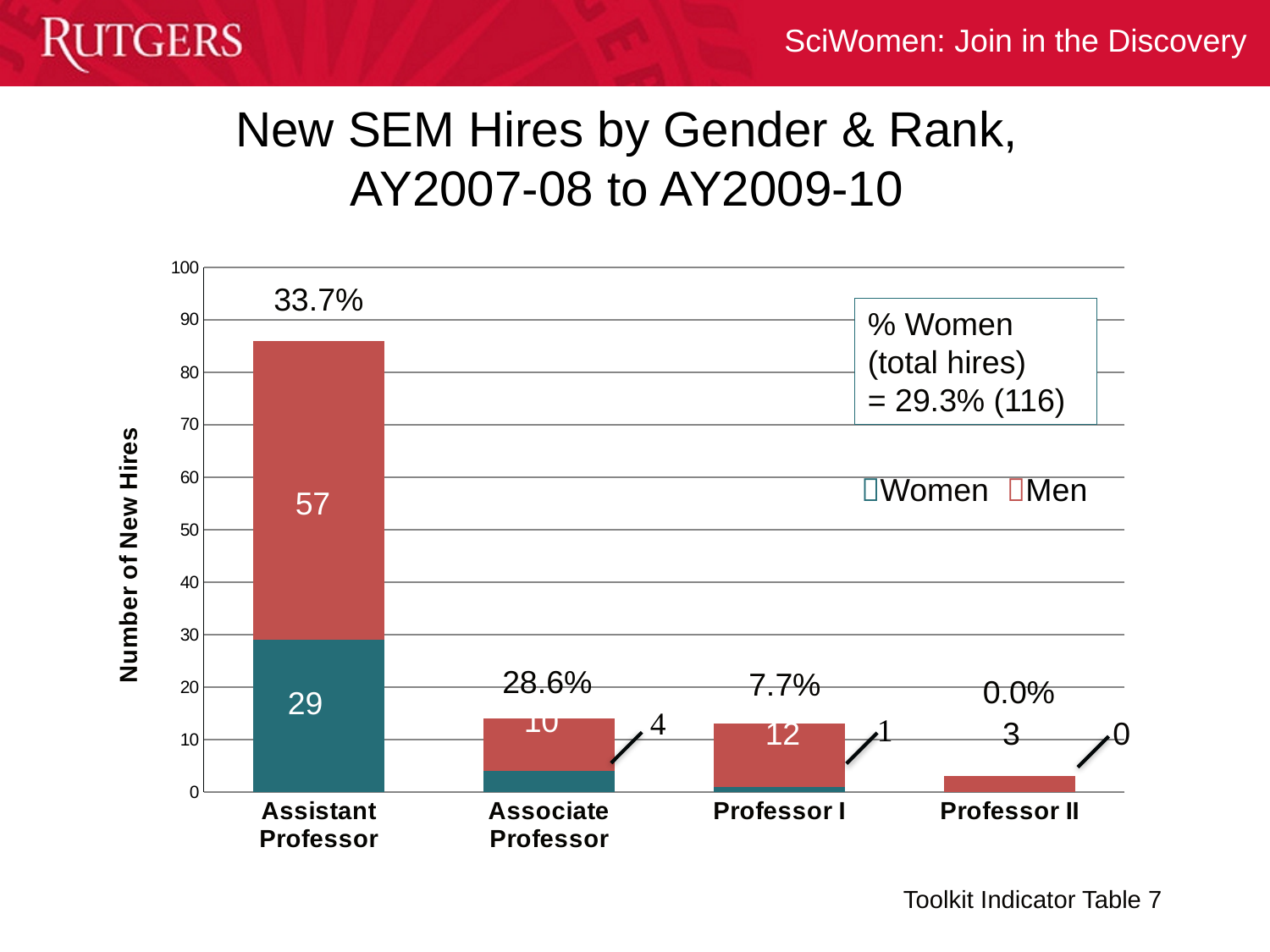
How many women were hired at the Professor II rank? 0 What is the total number of new hires at the Assistant Professor rank (women plus men)? 86 How many rank categories are shown on the x axis? 4 How many men were hired as Assistant Professor? 57 What kind of chart is shown on the slide? Stacked bar chart How many men were hired at the Professor I rank? 12 How many more men than women were hired as Assistant Professor? 28 What percentage of Assistant Professor hires were women? 33.7% How many series does the legend list? 2 What percentage of Professor I hires were women? 7.7% How many women were hired as Assistant Professor? 29 Which rank had the highest number of new hires? Assistant Professor